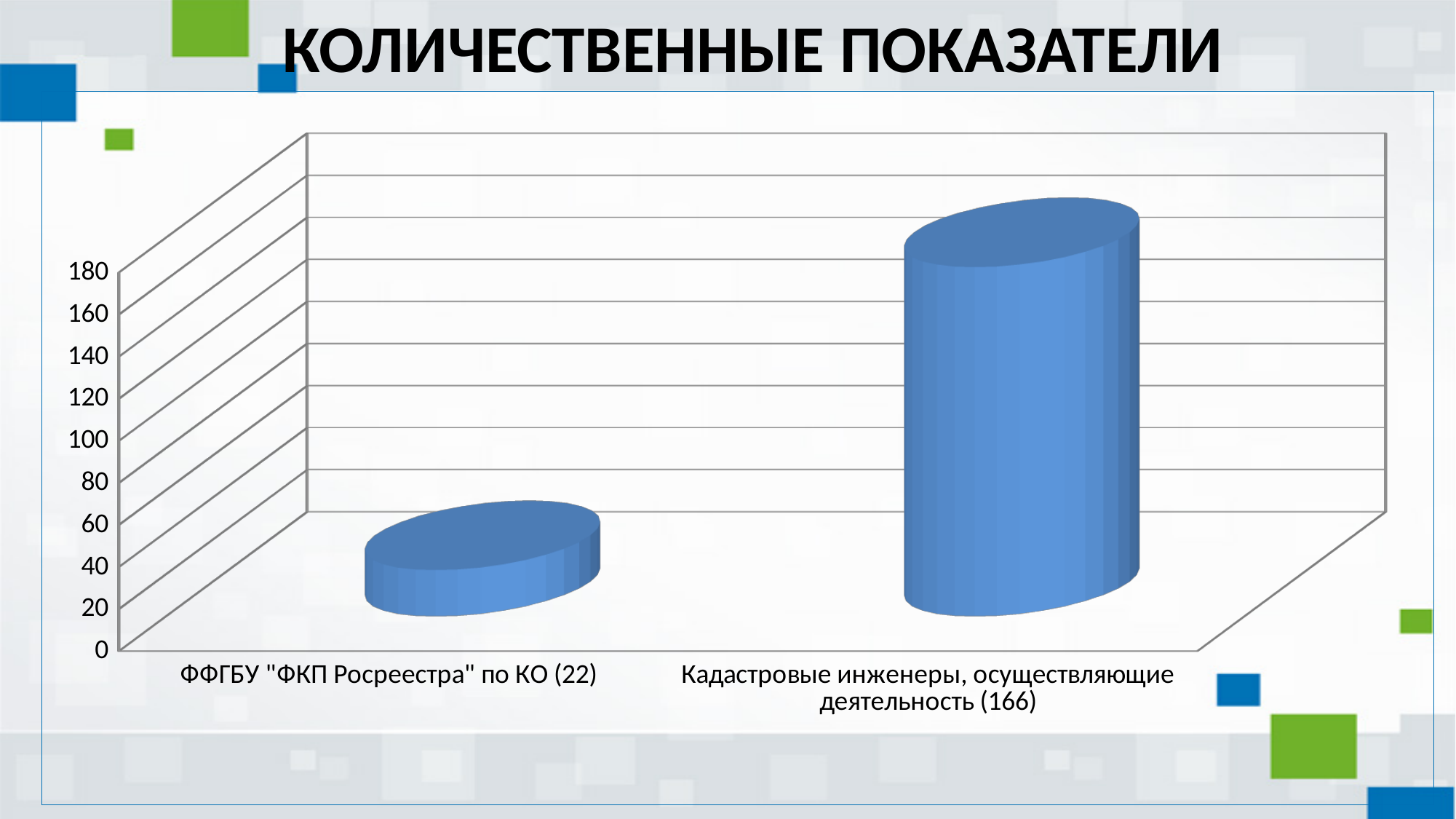
Which category has the lowest value? ФФГБУ "ФКП Росреестра" по КО What value is given for ФФГБУ "ФКП Росреестра" по КО? 22 What value is given for Кадастровые инженеры, осуществляющие деятельность? 166 What type of chart is shown on the slide? bar chart What is the difference between the value for Кадастровые инженеры, осуществляющие деятельность and the value for ФФГБУ "ФКП Росреестра" по КО? 144 Which category has the highest value? Кадастровые инженеры, осуществляющие деятельность How many categories are plotted in the chart? 2 Is the value for ФФГБУ "ФКП Росреестра" по КО greater or less than 60? less Which is larger: the value for ФФГБУ "ФКП Росреестра" по КО or the value for Кадастровые инженеры, осуществляющие деятельность? Кадастровые инженеры, осуществляющие деятельность What is the title of the slide's chart? КОЛИЧЕСТВЕННЫЕ ПОКАЗАТЕЛИ Is the value for Кадастровые инженеры, осуществляющие деятельность greater or less than 100? greater What is the maximum value shown on the vertical axis? 180